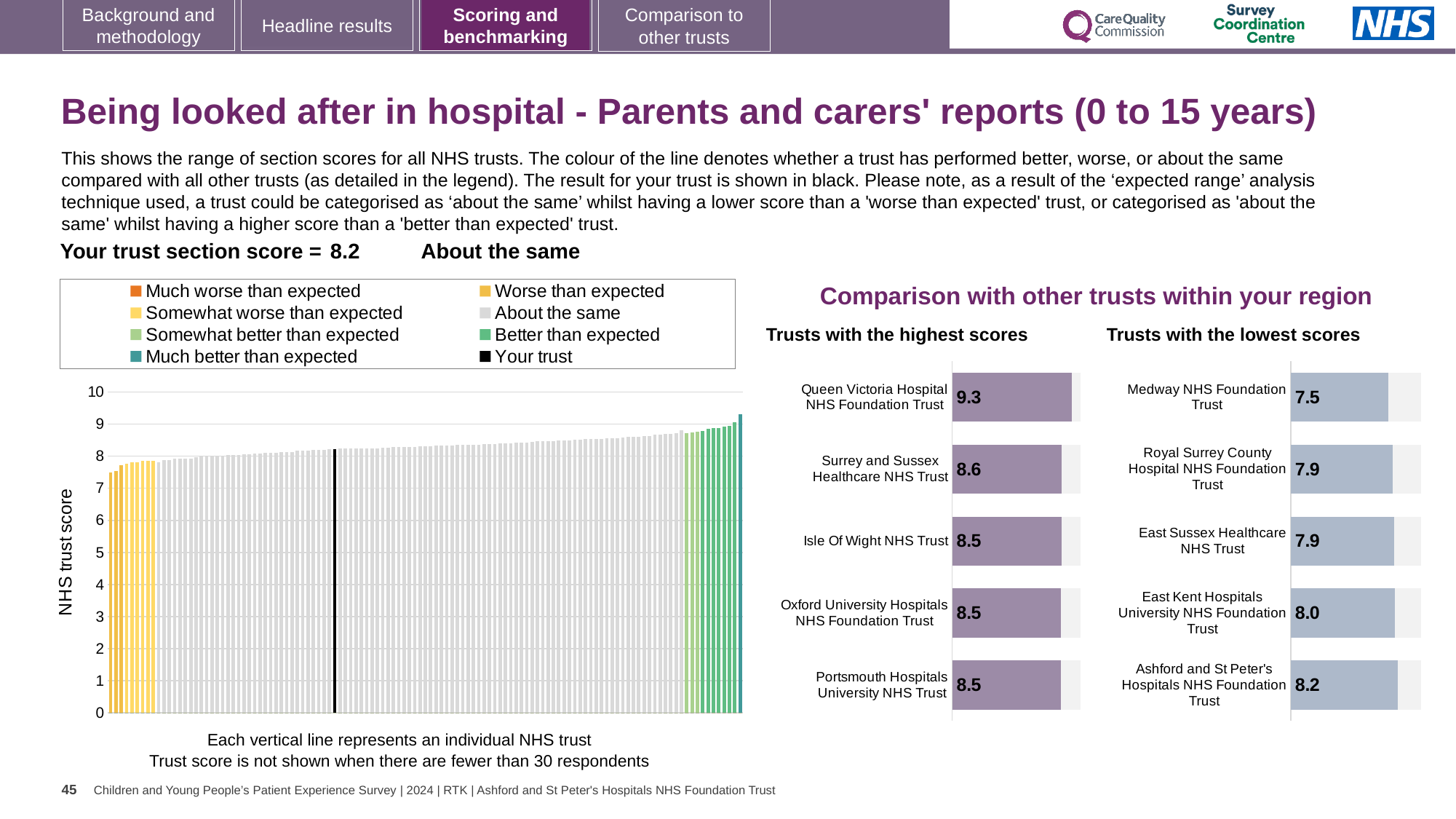
How many trusts are shown in the 'Trusts with the highest scores' chart? 5 In the 'Trusts with the lowest scores' chart, which trust has the lowest score? Medway NHS Foundation Trust In the main chart on the left, do the trust scores rise or fall from left to right along the x axis? rise In the 'Trusts with the lowest scores' chart, which has the larger score: East Kent Hospitals University NHS Foundation Trust or Medway NHS Foundation Trust? East Kent Hospitals University NHS Foundation Trust How many entries does the legend of the main chart on the left list? 8 In the 'Trusts with the highest scores' chart, what is the score for Queen Victoria Hospital NHS Foundation Trust? 9.3 In the 'Trusts with the highest scores' chart, what is the difference between the scores of Queen Victoria Hospital NHS Foundation Trust and Surrey and Sussex Healthcare NHS Trust? 0.7 What kind of chart is the main chart on the left showing all NHS trust scores? bar chart In the 'Trusts with the lowest scores' chart, what is the score for Medway NHS Foundation Trust? 7.5 In the main chart on the left, is the value for the black 'Your trust' bar greater or less than 8? greater In the 'Trusts with the highest scores' chart, which trust has the highest score? Queen Victoria Hospital NHS Foundation Trust In the 'Trusts with the lowest scores' chart, what is the score for Ashford and St Peter's Hospitals NHS Foundation Trust? 8.2